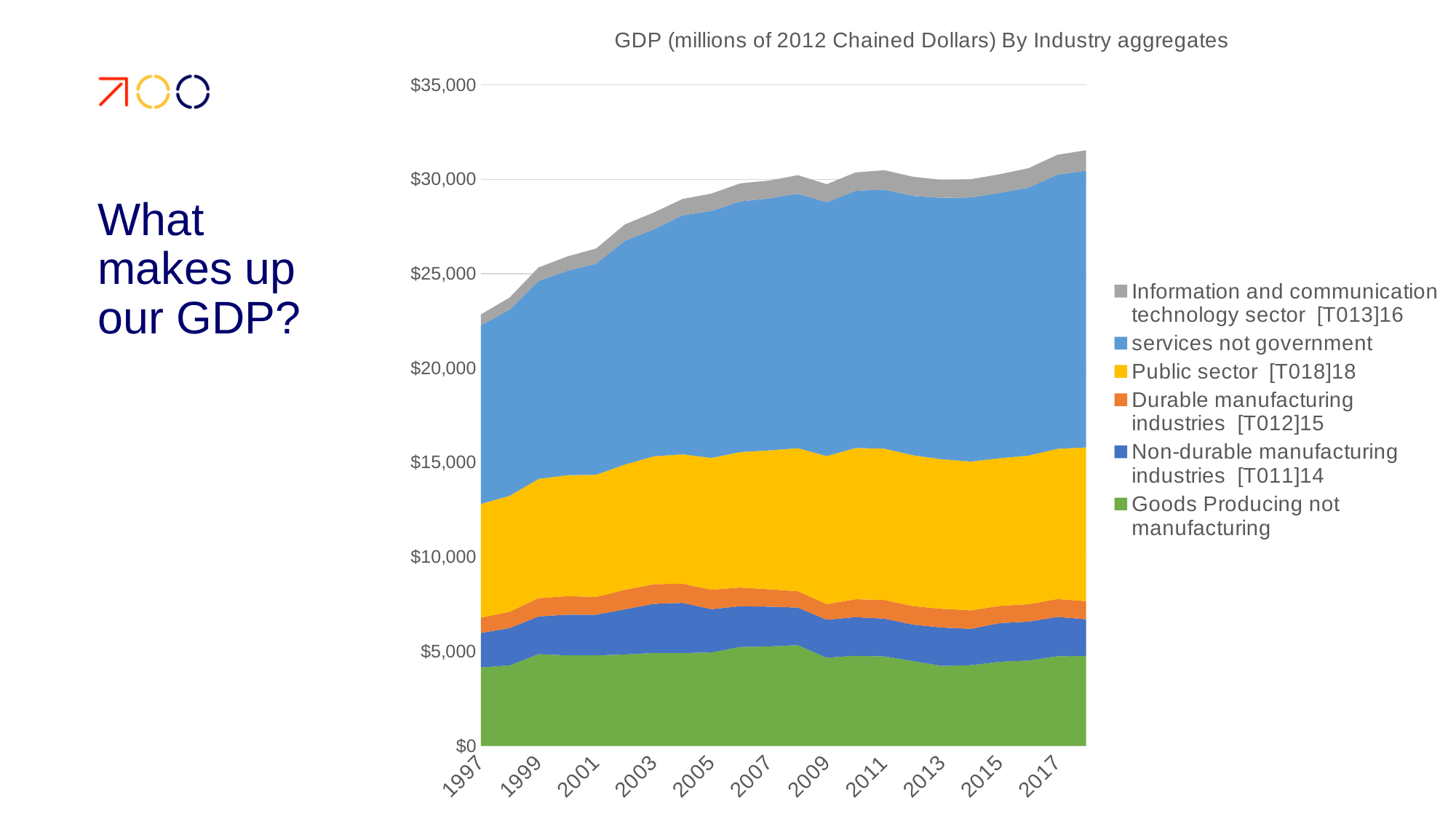
Is the total GDP in 2017 larger or smaller than the total GDP in 1997? larger What is the highest value shown on the y axis? $35,000 Which series is plotted at the bottom of the stack? Goods Producing not manufacturing Is the total GDP in 2017 greater or less than $30,000? greater Does the total GDP generally rise or fall from 1997 to 2017? Rise Is the value for Goods Producing not manufacturing in 1997 greater or less than $5,000? less Is the total GDP in 1997 greater or less than $25,000? less Which series takes up the largest share of the stacked area? services not government How many series does the legend list? 6 What type of chart is shown on the slide? Stacked area chart What is the title of the chart? GDP (millions of 2012 Chained Dollars) By Industry aggregates